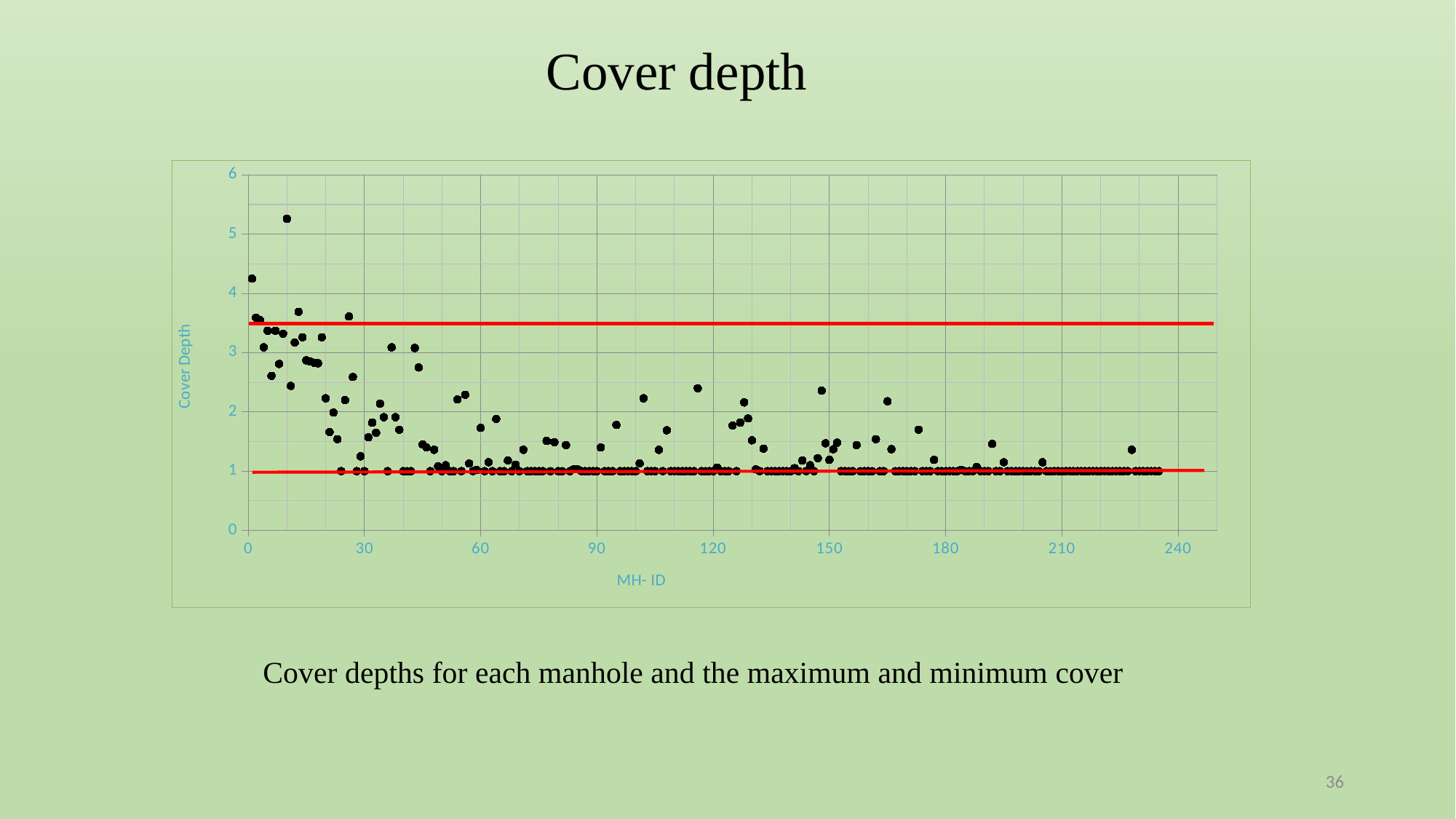
Is the cover depth of the highest point near MH-ID 10 greater or less than 4? greater What is the title of the chart's y axis? Cover Depth Is the cover depth of the point near MH-ID 228 greater or less than 2? less Is the lower red horizontal line greater or less than 2 on the Cover Depth axis? less What kind of chart is shown on the slide? scatter chart What is the title of the chart's x axis? MH- ID Do the plotted cover depth values generally rise or fall as MH-ID increases along the x axis? fall What is the highest value shown on the Cover Depth axis? 6